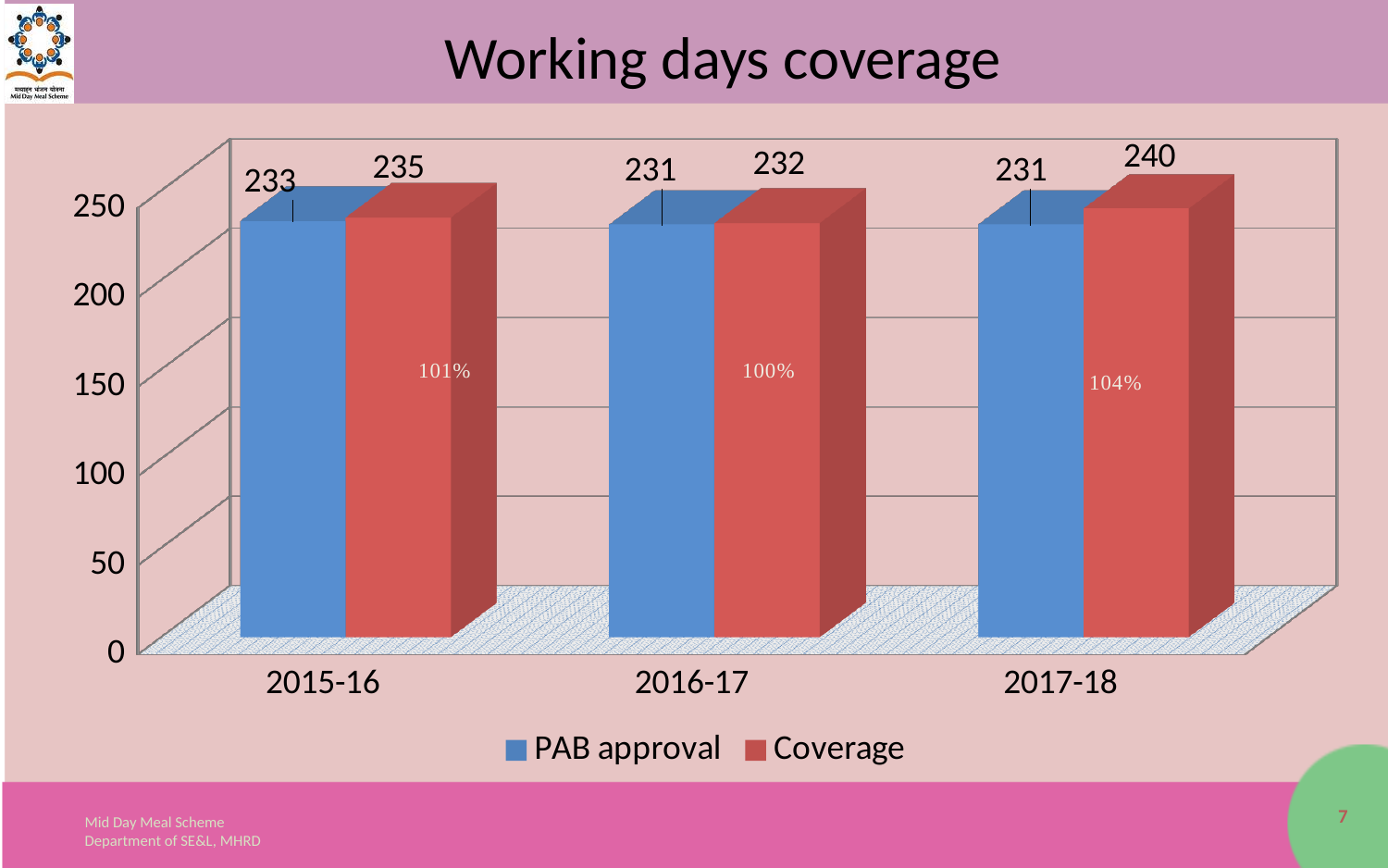
What is the difference between Coverage and PAB approval in 2017-18? 9 Which year has the lowest PAB approval value? 2016-17 and 2017-18 (both 231) What is the Coverage value for 2017-18? 240 How many years are shown on the x axis? 3 Which is larger in 2016-17, PAB approval or Coverage? Coverage Which year has the highest Coverage value? 2017-18 How many series does the legend list? 2 What is the PAB approval value for 2015-16? 233 What kind of chart is shown on the slide? Bar chart What is the Coverage value for 2016-17? 232 What is the difference between Coverage and PAB approval in 2015-16? 2 What percentage label is shown on the Coverage bar for 2017-18? 104%